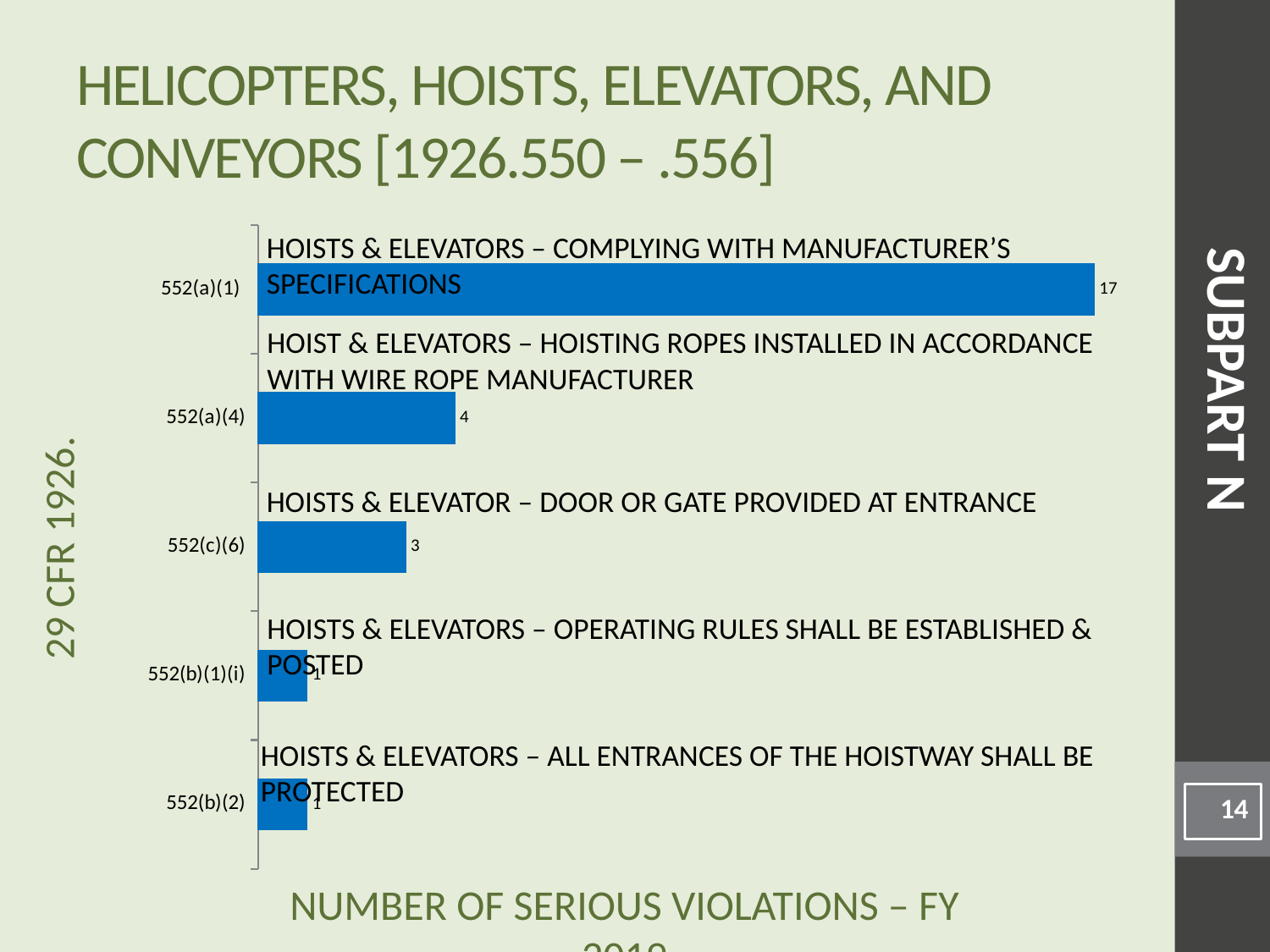
Which standard has the highest number of serious violations? 552(a)(1) What is the number of serious violations for 552(a)(4)? 4 What colour are the bars in the chart? Blue What is the number of serious violations for 552(c)(6)? 3 What is the number of serious violations for 552(a)(1)? 17 How many standards (categories) are shown in the chart? 5 What is the total number of serious violations across all five standards shown? 26 Which has more serious violations, 552(c)(6) or 552(b)(2)? 552(c)(6) What is the difference between the number of violations for 552(a)(4) and 552(c)(6)? 1 What is the number of serious violations for 552(b)(1)(i)? 1 What is the difference between the number of violations for 552(a)(1) and 552(a)(4)? 13 What type of chart is shown on the slide? Bar chart